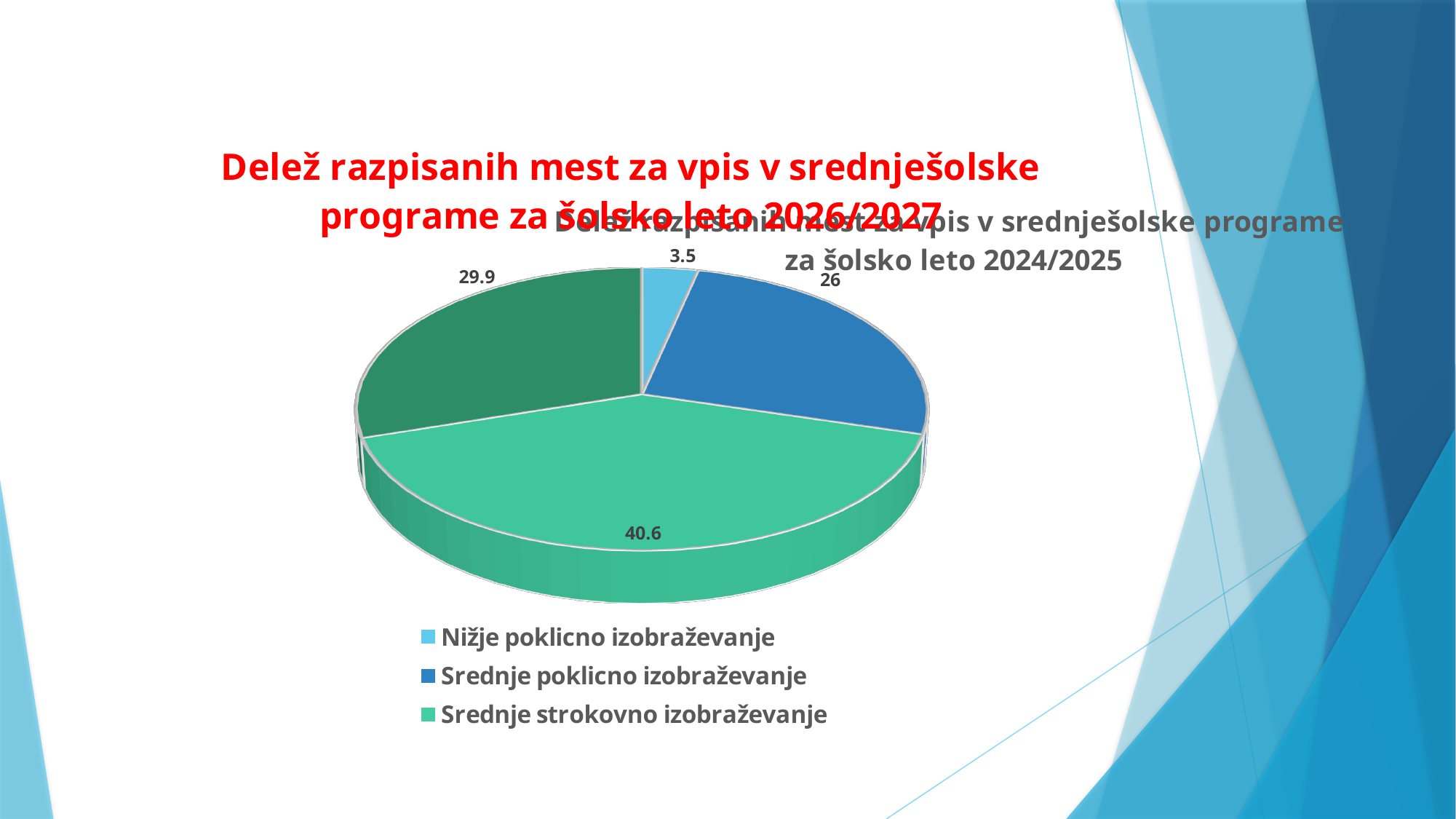
What is the difference between the values for Srednje poklicno izobraževanje and Nižje poklicno izobraževanje? 22.5 What is the value for Nižje poklicno izobraževanje in the pie chart? 3.5 What type of chart is shown on the slide? Pie chart Which is larger: the slice for Srednje poklicno izobraževanje or the slice for Nižje poklicno izobraževanje? Srednje poklicno izobraževanje Which category has the smallest slice in the pie chart? Nižje poklicno izobraževanje Which category has the largest slice in the pie chart? Srednje strokovno izobraževanje What is the value for Srednje strokovno izobraževanje in the pie chart? 40.6 What school year is named in the grey chart title? 2024/2025 What is the difference between the values for Srednje strokovno izobraževanje and Srednje poklicno izobraževanje? 14.6 How many slices does the pie chart have? 4 What is the value for Srednje poklicno izobraževanje in the pie chart? 26 How many entries does the chart legend list? 3